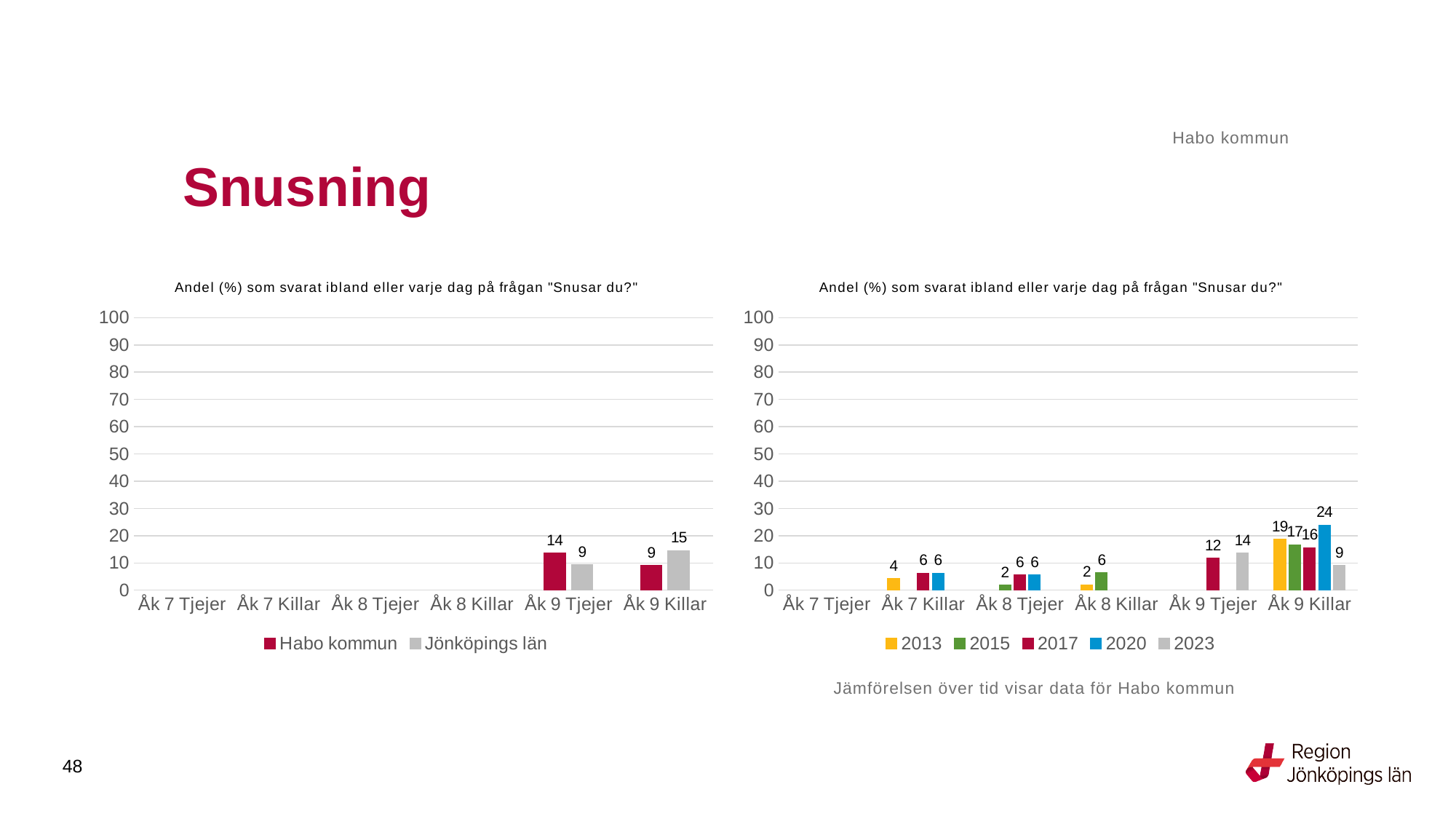
In the left chart, what is the difference between Jönköpings län and Habo kommun for Åk 9 Killar? 6 In the right chart, what is the value for 2020 for Åk 9 Killar? 24 How many series does the legend of the left chart list? 2 What kind of chart is the right chart? Bar chart In the left chart, which is larger for Åk 9 Tjejer: Habo kommun or Jönköpings län? Habo kommun In the right chart, what is the difference between 2023 and 2017 for Åk 9 Tjejer? 2 In the right chart, what is the value for 2013 for Åk 7 Killar? 4 In the right chart, which year has the highest value for Åk 9 Killar? 2020 In the left chart, what is the value for Jönköpings län for Åk 9 Killar? 15 In the left chart, what is the value for Habo kommun for Åk 9 Tjejer? 14 How many series does the legend of the right chart list? 5 In the right chart, which year has the lowest value for Åk 9 Killar? 2023